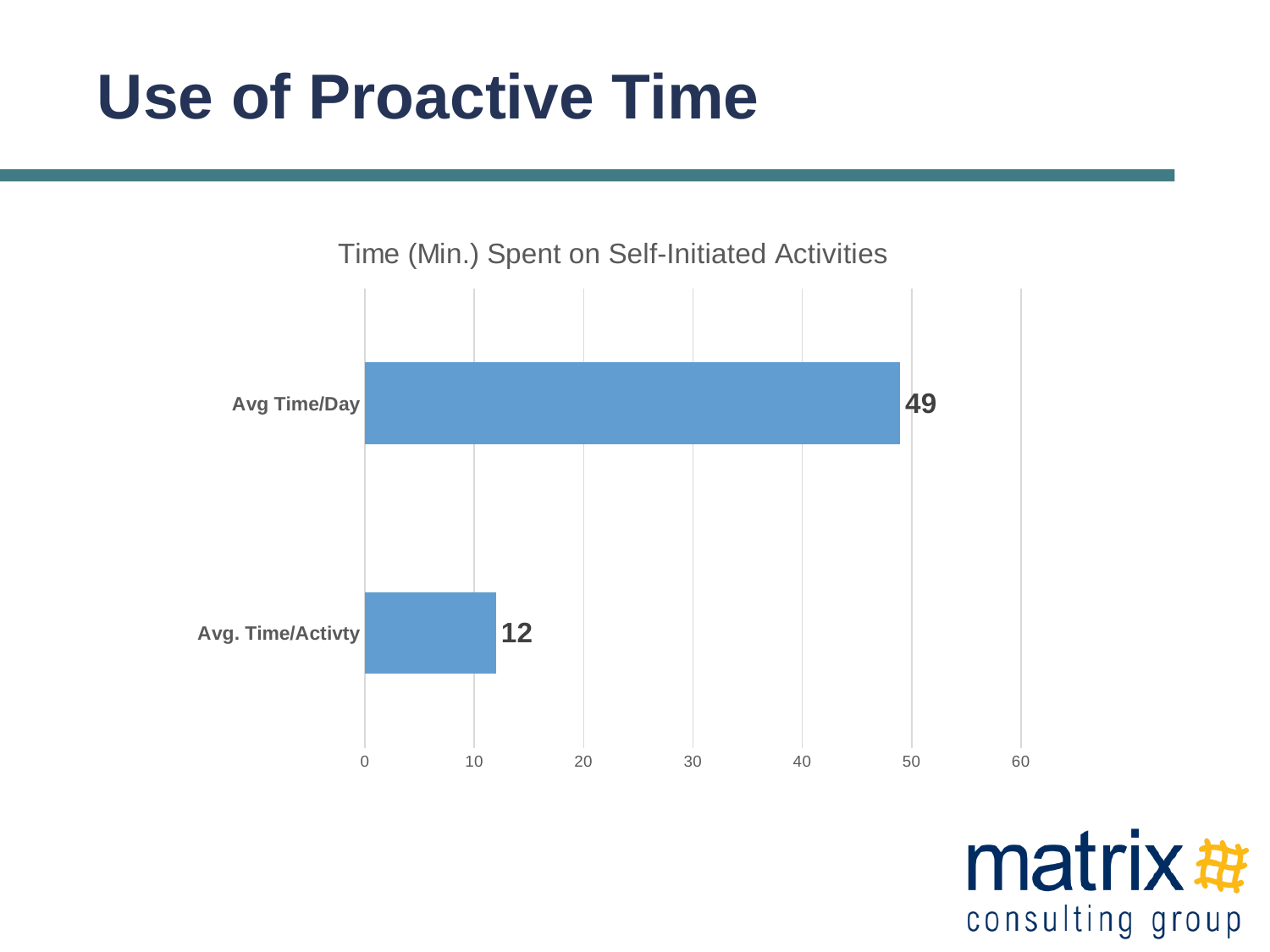
What is the title of the chart? Time (Min.) Spent on Self-Initiated Activities What is the highest value shown on the x axis? 60 What is the value for Avg. Time/Activty? 12 Which category has the highest value? Avg Time/Day Which is larger, the value for Avg Time/Day or the value for Avg. Time/Activty? Avg Time/Day Is the value for Avg. Time/Activty greater or less than 20? less What is the difference between the values for Avg Time/Day and Avg. Time/Activty? 37 Which category has the lowest value? Avg. Time/Activty What kind of chart is shown on the slide? Bar chart How many categories are shown in the chart? 2 Is the value for Avg Time/Day greater or less than 40? greater What is the value for Avg Time/Day? 49